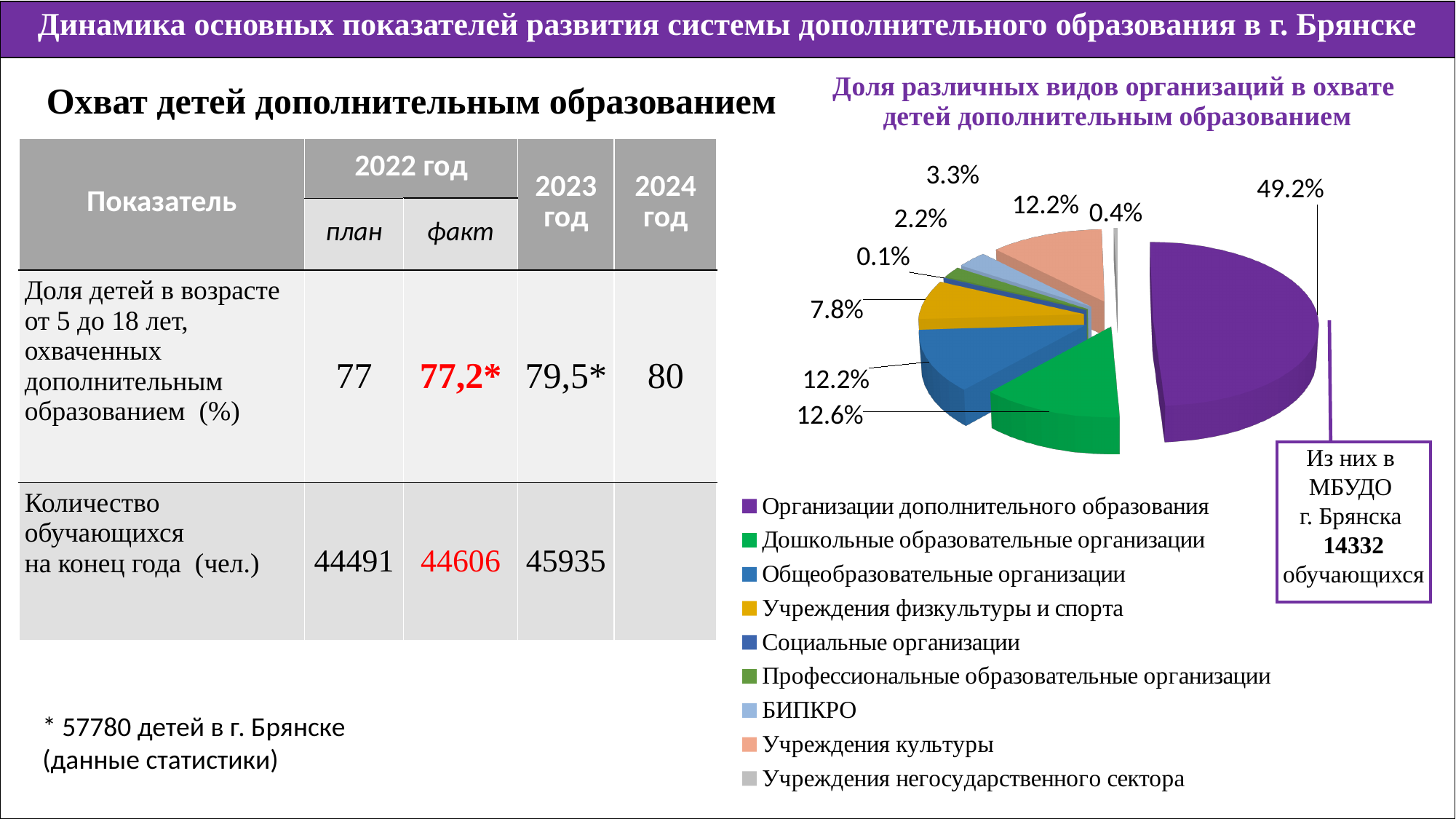
What is the value for 'Учреждения культуры' in the pie chart? 12.2% What is the value for 'Дошкольные образовательные организации' in the pie chart? 12.6% What kind of chart is shown on the slide? pie chart What is the value for 'БИПКРО' in the pie chart? 3.3% Which is larger in the pie chart: 'Учреждения физкультуры и спорта' or 'Профессиональные образовательные организации'? Учреждения физкультуры и спорта What is the difference between the shares of 'Организации дополнительного образования' and 'Дошкольные образовательные организации'? 36.6% Which category has the smallest slice in the pie chart? Социальные организации How many categories does the pie chart show? 9 What is the value for 'Учреждения физкультуры и спорта' in the pie chart? 7.8% What share of the pie chart does 'Организации дополнительного образования' have? 49.2% Which category has the largest slice in the pie chart? Организации дополнительного образования What colour is the slice for 'Общеобразовательные организации' in the pie chart? blue